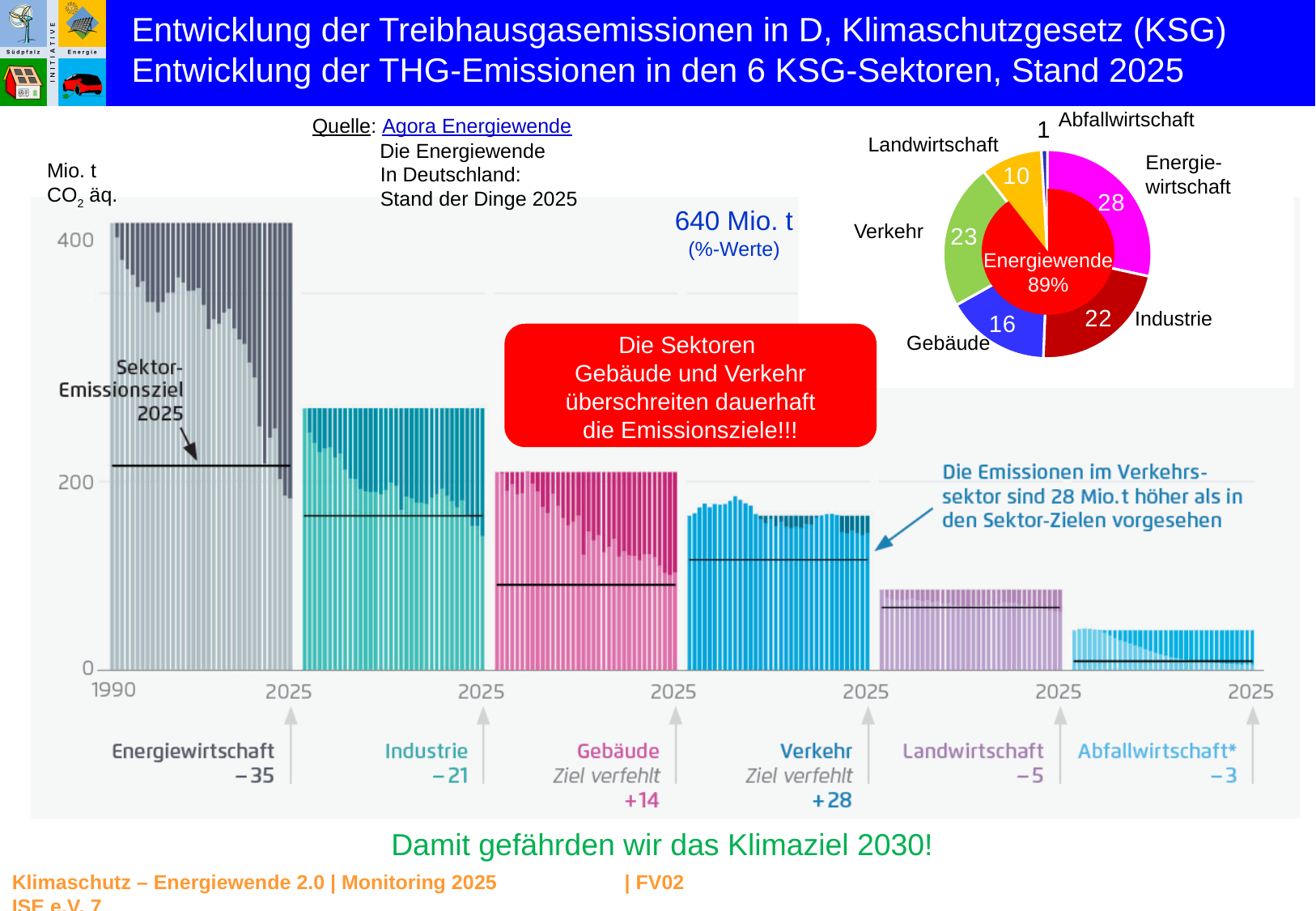
How many sectors are shown in the pie chart? 6 What total amount of emissions does the pie chart represent? 640 Mio. t In the pie chart, which sector has the smallest share? Abfallwirtschaft In the bar chart, what deviation from the 2025 target is shown for Energiewirtschaft? −35 In the pie chart, which sector has the largest share? Energiewirtschaft What kind of chart is the large chart showing emissions from 1990 to 2025 by sector? bar chart In the pie chart, what percentage share does Energiewirtschaft have? 28 In the pie chart, what is the difference between the shares of Verkehr and Industrie? 1 In the bar chart, do the emissions of Energiewirtschaft rise or fall from 1990 to 2025? fall In the bar chart, is the Energiewirtschaft emissions value in 1990 greater or less than 400? greater In the bar chart, by how much does the Verkehr sector exceed its 2025 sector target? +28 In the bar chart, which two sectors are marked as 'Ziel verfehlt'? Gebäude and Verkehr